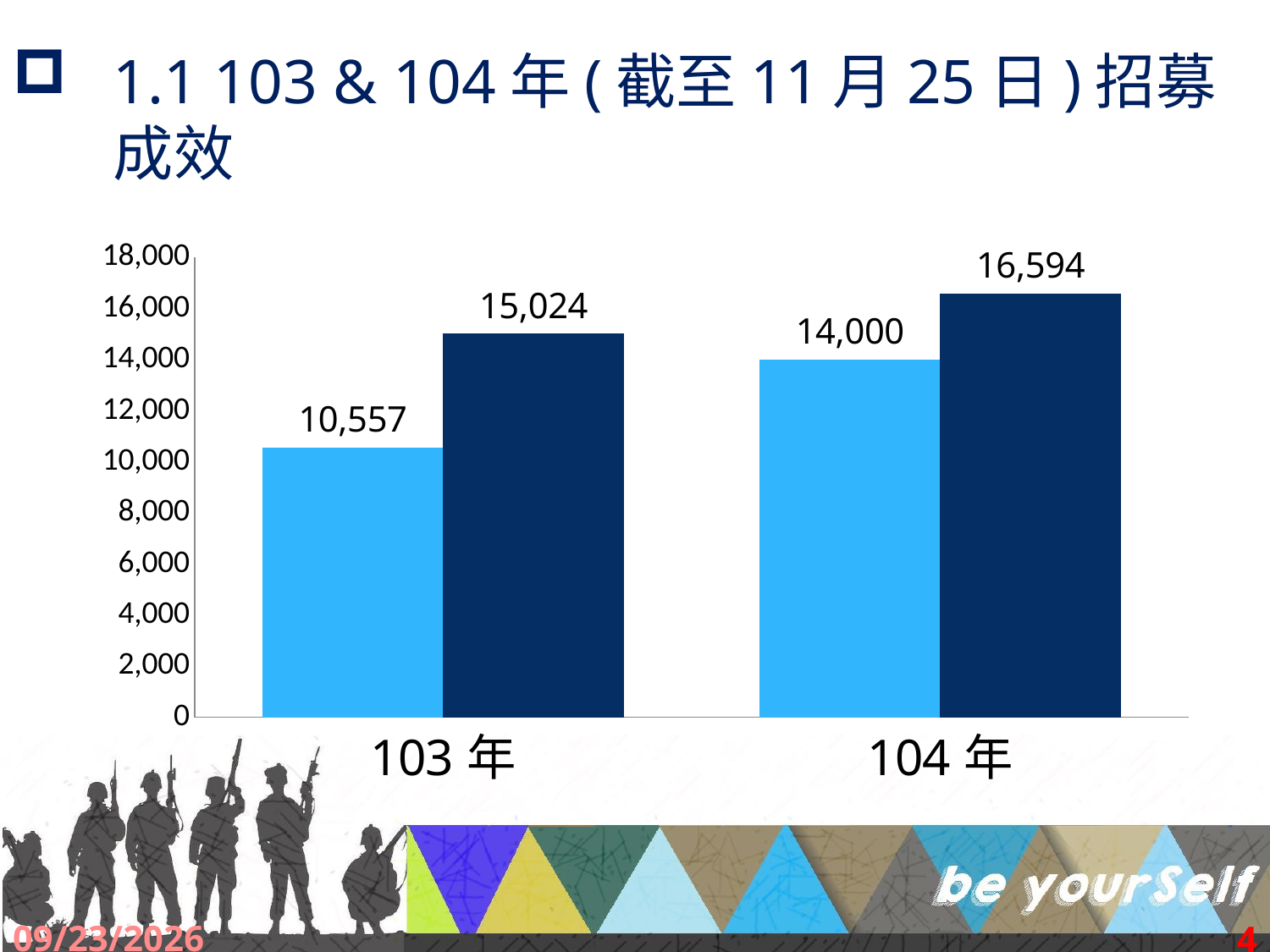
What kind of chart is shown on the slide? Bar chart What is the value of the dark blue bar for 104 年? 16,594 Which bar has the lowest value in the chart? Light blue bar for 103 年 (10,557) Which bar has the highest value in the chart? Dark blue bar for 104 年 (16,594) What is the value of the light blue bar for 103 年? 10,557 What is the value of the light blue bar for 104 年? 14,000 What is the difference between the dark blue bars for 104 年 and 103 年? 1,570 What is the value of the dark blue bar for 103 年? 15,024 How many categories are shown on the x axis? 2 What is the difference between the dark blue and light blue bars for 103 年? 4,467 Do the light blue bar values rise or fall from 103 年 to 104 年? Rise Which is larger: the light blue bar for 104 年 or the dark blue bar for 103 年? Dark blue bar for 103 年